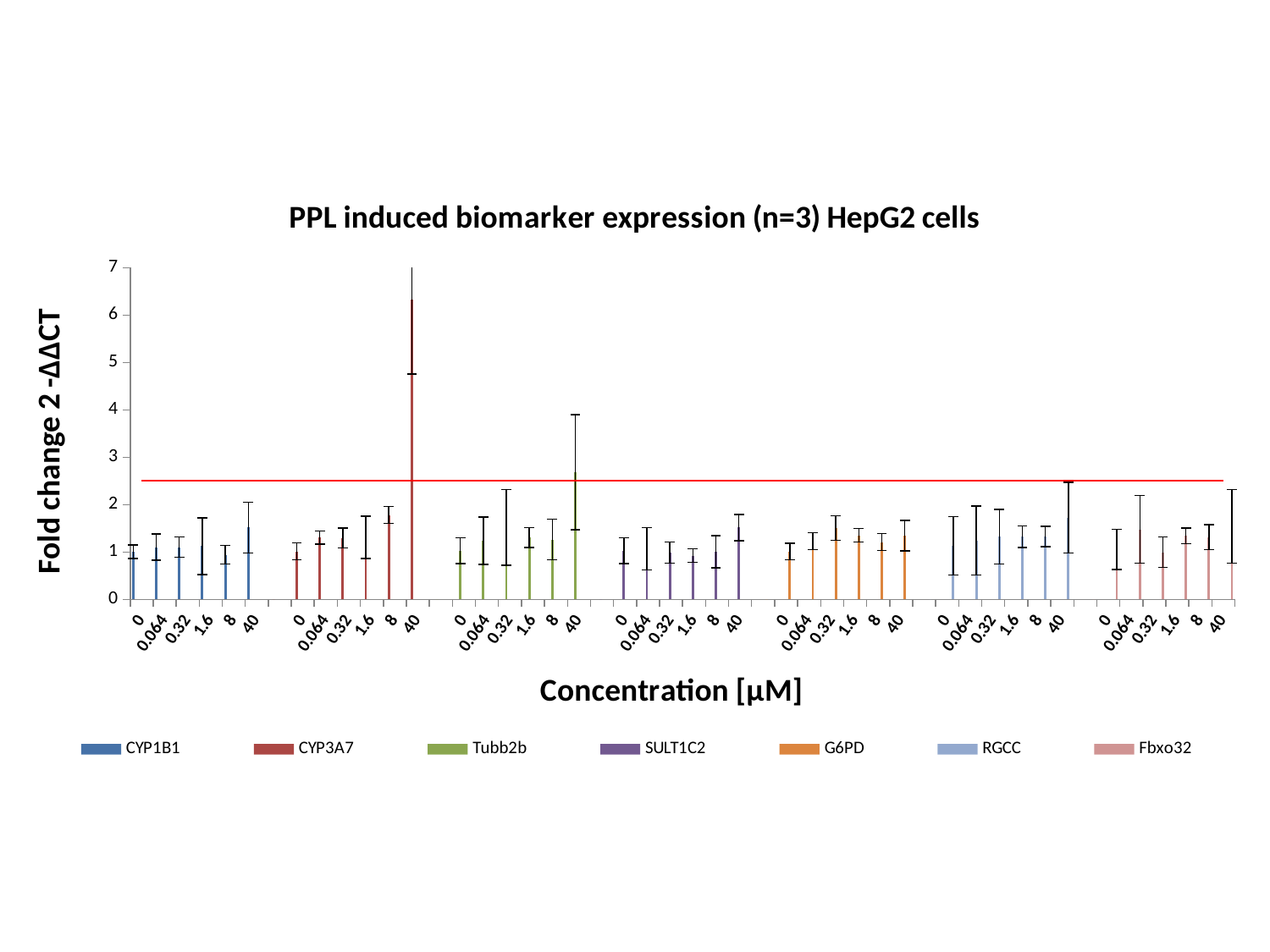
Is the value for CYP1B1 at 0 µM greater or less than 2? less What kind of chart is shown on the slide? bar chart What is the title of the chart? PPL induced biomarker expression (n=3) HepG2 cells What is the label of the x axis? Concentration [µM] How many series does the legend list? 7 Is the value for Tubb2b at 40 µM greater or less than 2? greater Which is larger, the value for CYP1B1 at 40 µM or the value for CYP3A7 at 40 µM? CYP3A7 at 40 µM Which series has the highest bar on the chart? CYP3A7 Is the value for CYP3A7 at 40 µM greater or less than 4? greater How many concentration categories are plotted for each series? 6 Which is larger, the value for CYP3A7 at 40 µM or the value for Tubb2b at 40 µM? CYP3A7 at 40 µM